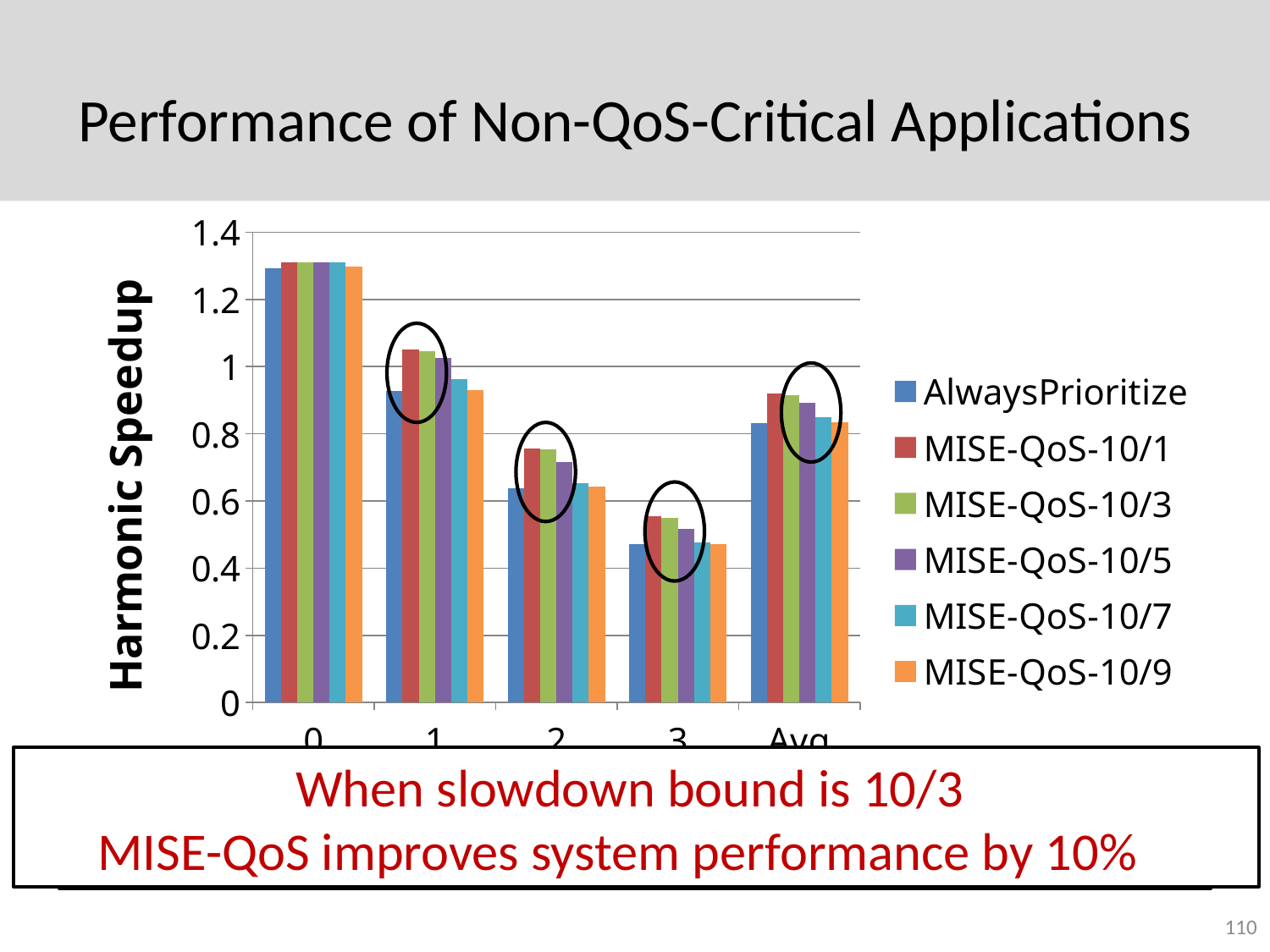
Is the MISE-QoS-10/1 value for category 1 greater or less than 1? greater Is the AlwaysPrioritize value for category 3 greater or less than 0.6? less What kind of chart is shown on the slide? bar chart For category 1, which is larger: AlwaysPrioritize or MISE-QoS-10/1? MISE-QoS-10/1 Which category has the lowest Harmonic Speedup values across all series? 3 What is the y-axis title of the chart? Harmonic Speedup Is the AlwaysPrioritize value for category 0 greater or less than 1.2? greater Which legend entry is shown in orange? MISE-QoS-10/9 Which category has the highest Harmonic Speedup values across all series? 0 How many series does the legend list? 6 How many categories are shown on the x axis? 5